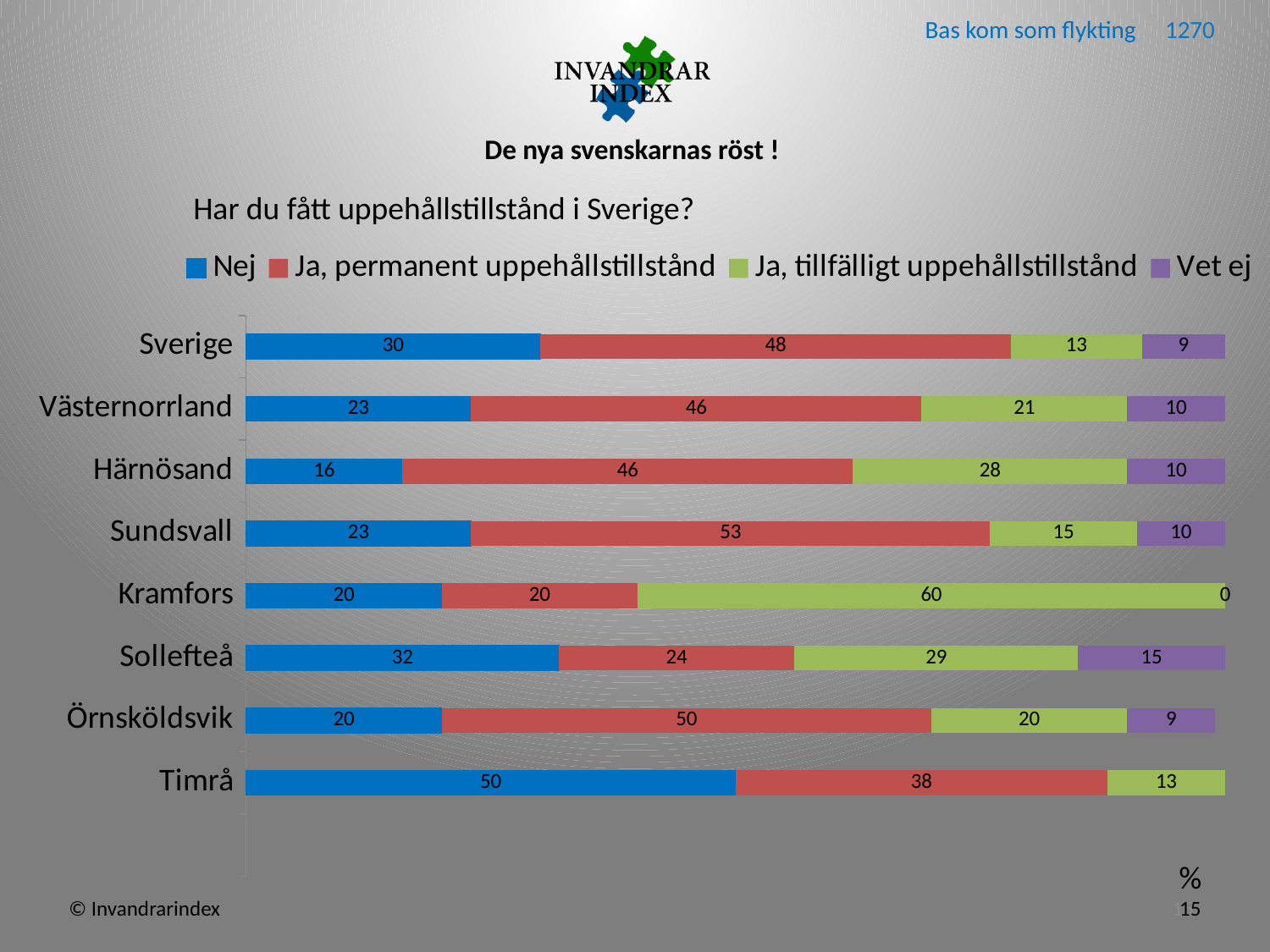
Which is larger: the "Ja, tillfälligt uppehållstillstånd" value for Härnösand or for Västernorrland? Härnösand What is the value for "Ja, tillfälligt uppehållstillstånd" for Kramfors? 60 How many categories (regions) are shown on the chart? 8 What is the value for "Vet ej" for Sollefteå? 15 Which region has the lowest value for "Nej"? Härnösand What is the value for "Nej" for Timrå? 50 What is the difference between the "Ja, permanent uppehållstillstånd" values for Sverige and Sollefteå? 24 Which region has the highest value for "Nej"? Timrå What kind of chart is shown on the slide? stacked bar chart How many series does the legend list? 4 What question is the chart about, as shown in its title? Har du fått uppehållstillstånd i Sverige? What is the value for "Ja, permanent uppehållstillstånd" for Sundsvall? 53